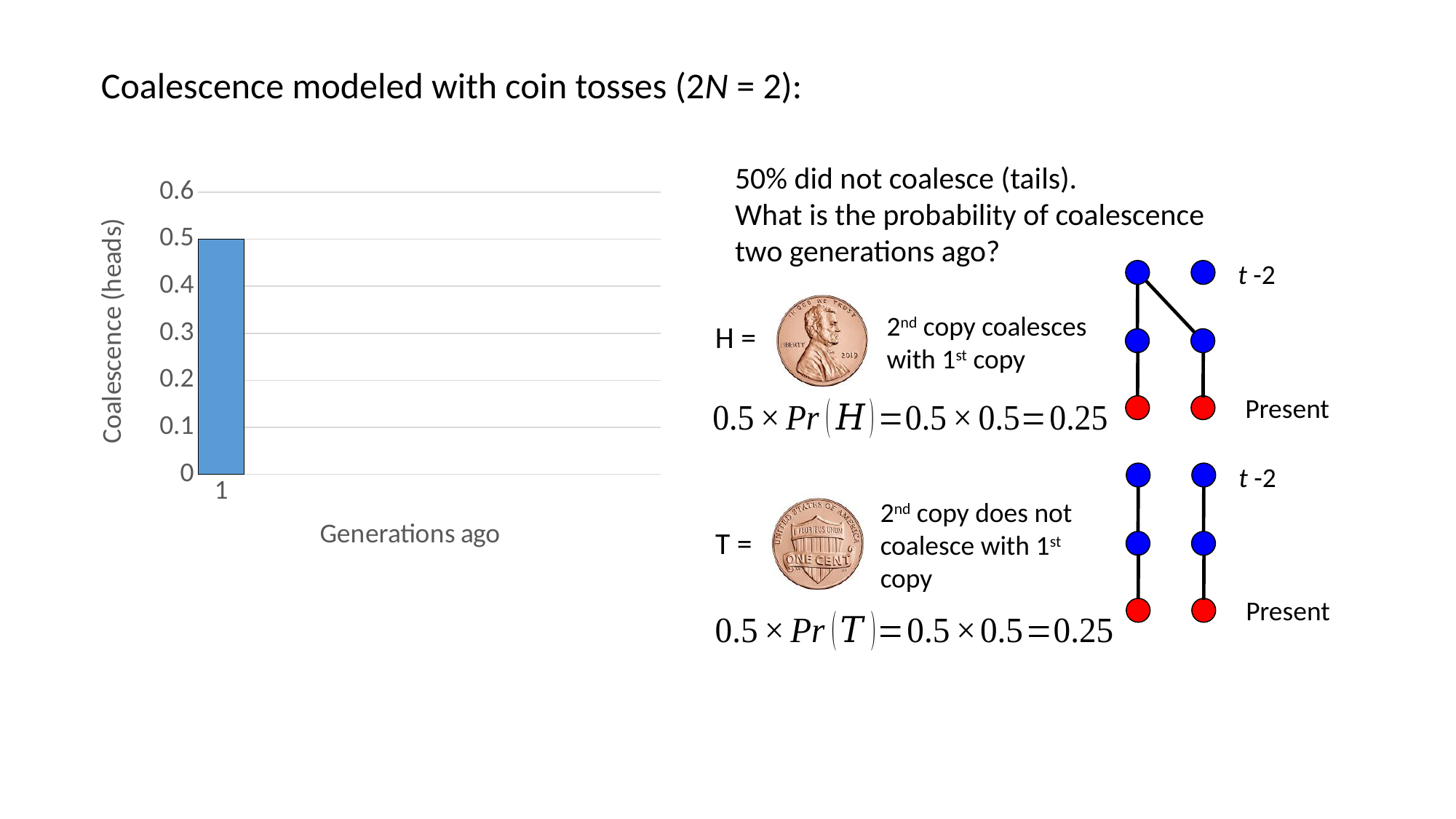
What is the highest value shown on the vertical axis of the chart? 0.6 What is the label of the horizontal axis of the chart? Generations ago Is the value for generation 1 greater or less than 0.4? greater What is the value of the bar for generation 1 in the chart? 0.5 How many bars are plotted in the chart? 1 What is the label of the vertical axis of the chart? Coalescence (heads) What kind of chart is shown on the slide? bar chart Is the value for generation 1 greater or less than 0.6? less